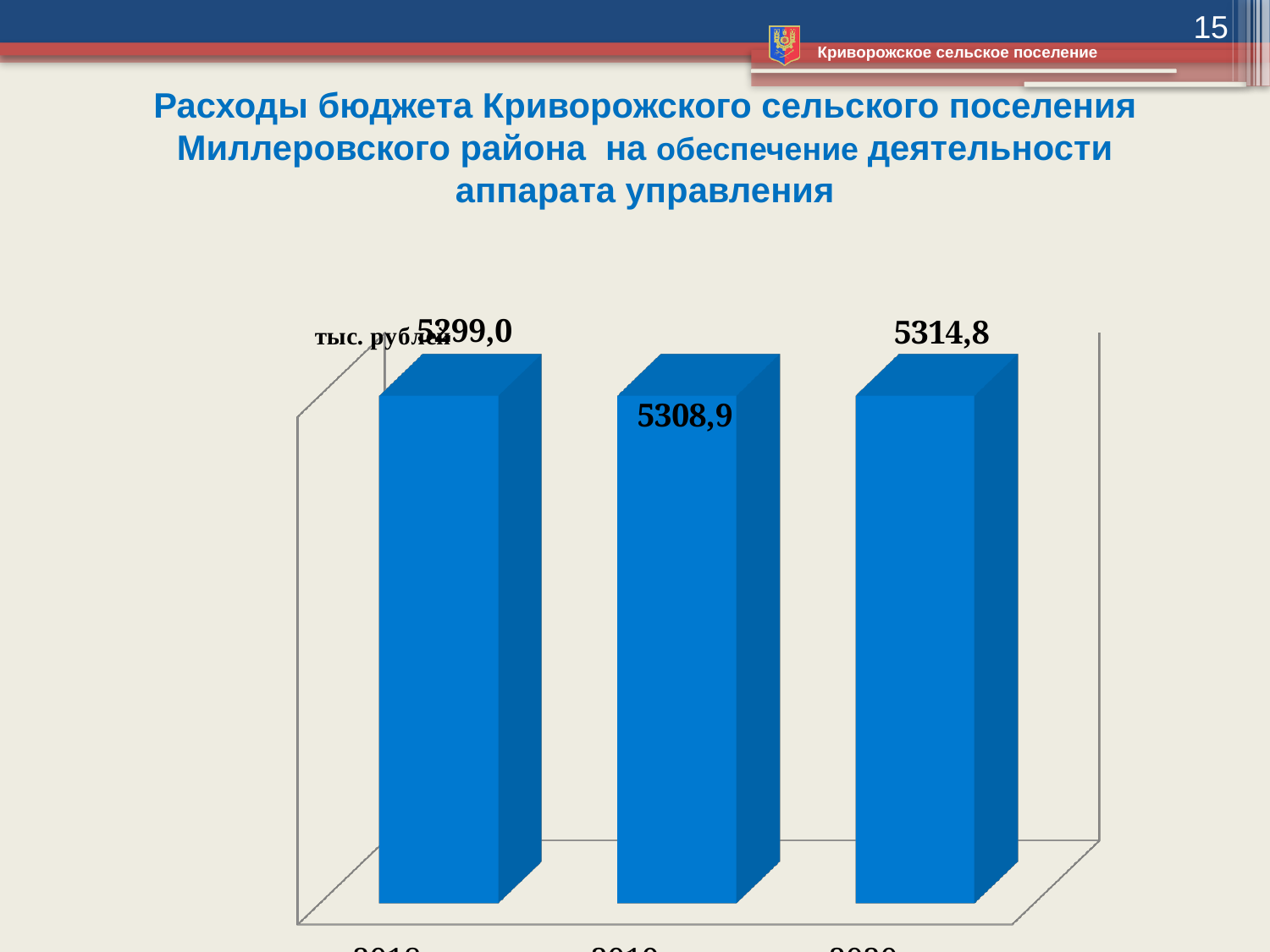
Do the values rise or fall from left to right across the chart? rise What is the difference between the middle bar's value and the leftmost bar's value? 9,9 What is the value shown on the middle bar of the chart? 5308,9 In what unit are the chart values given, according to the label on the chart? тыс. рублей Which bar has the lowest value according to the data labels? the leftmost bar (5299,0) What is the value shown on the leftmost bar of the chart? 5299,0 What is the difference between the rightmost bar's value and the middle bar's value? 5,9 According to the data labels, which is larger: the middle bar's value or the rightmost bar's value? the rightmost bar's value (5314,8) What is the value shown on the rightmost bar of the chart? 5314,8 Which bar has the highest value according to the data labels? the rightmost bar (5314,8) What kind of chart is shown on the slide? bar chart How many bars does the chart show? 3